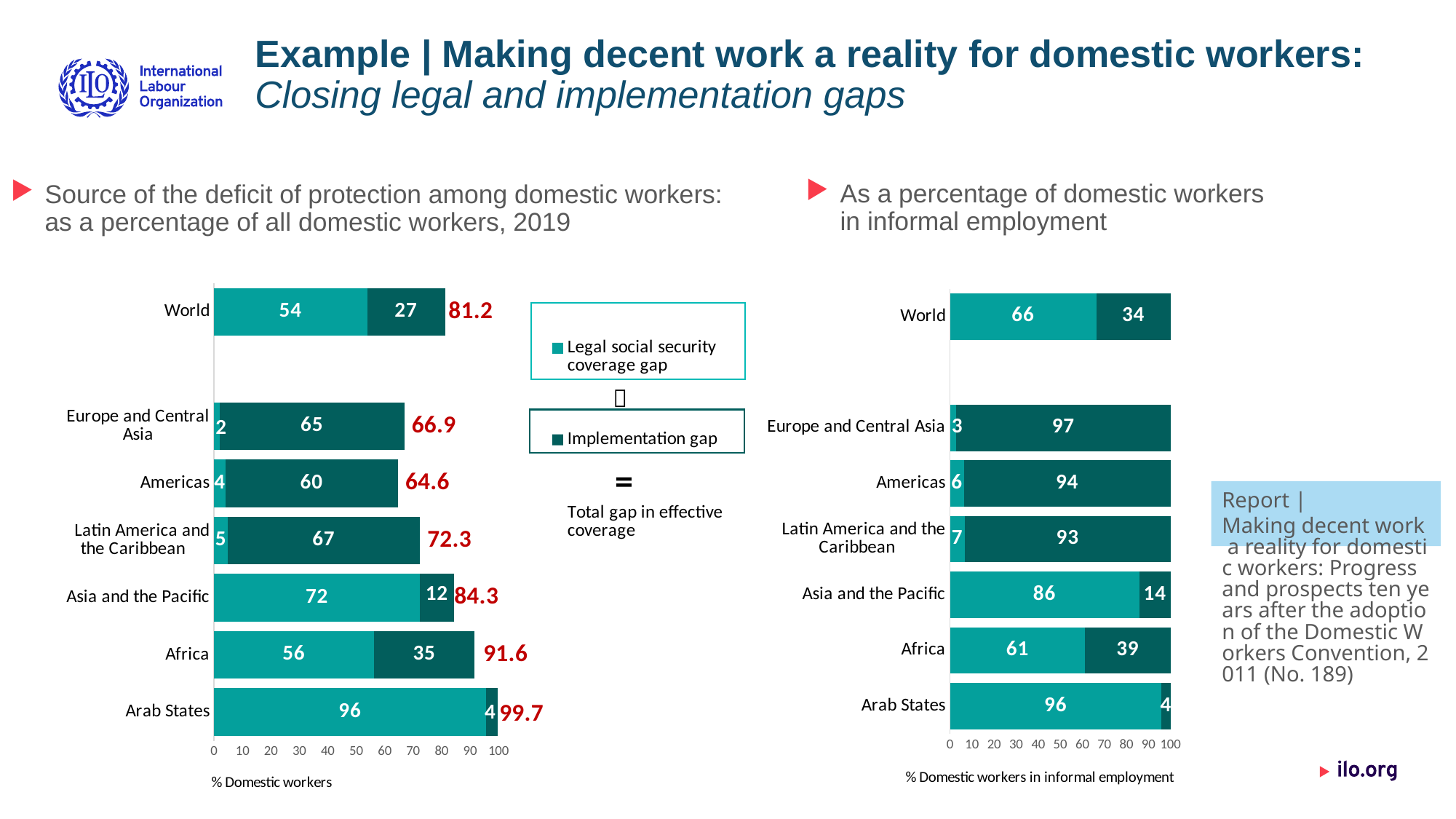
In the left chart (Source of the deficit of protection among domestic workers), what is the legal social security coverage gap for Asia and the Pacific? 72 In the left chart (Source of the deficit of protection among domestic workers), what is the difference between the legal social security coverage gap and the implementation gap for the World? 27 In the left chart (Source of the deficit of protection among domestic workers), which region has the highest total gap in effective coverage? Arab States In the right chart (As a percentage of domestic workers in informal employment), what is the implementation gap for Latin America and the Caribbean? 93 In the right chart (As a percentage of domestic workers in informal employment), what is the legal social security coverage gap for Africa? 61 In the left chart (Source of the deficit of protection among domestic workers), what is the total gap in effective coverage shown for Africa? 91.6 In the right chart (As a percentage of domestic workers in informal employment), is the legal social security coverage gap larger for Asia and the Pacific or for the World? Asia and the Pacific In the right chart (As a percentage of domestic workers in informal employment), which region has the highest implementation gap? Europe and Central Asia In the left chart (Source of the deficit of protection among domestic workers), which region has the lowest total gap in effective coverage? Americas In the left chart (Source of the deficit of protection among domestic workers), what is the implementation gap for Europe and Central Asia? 65 How many regions (including World) are shown in the left chart (Source of the deficit of protection among domestic workers)? 7 How many series does the legend between the two charts list? 2